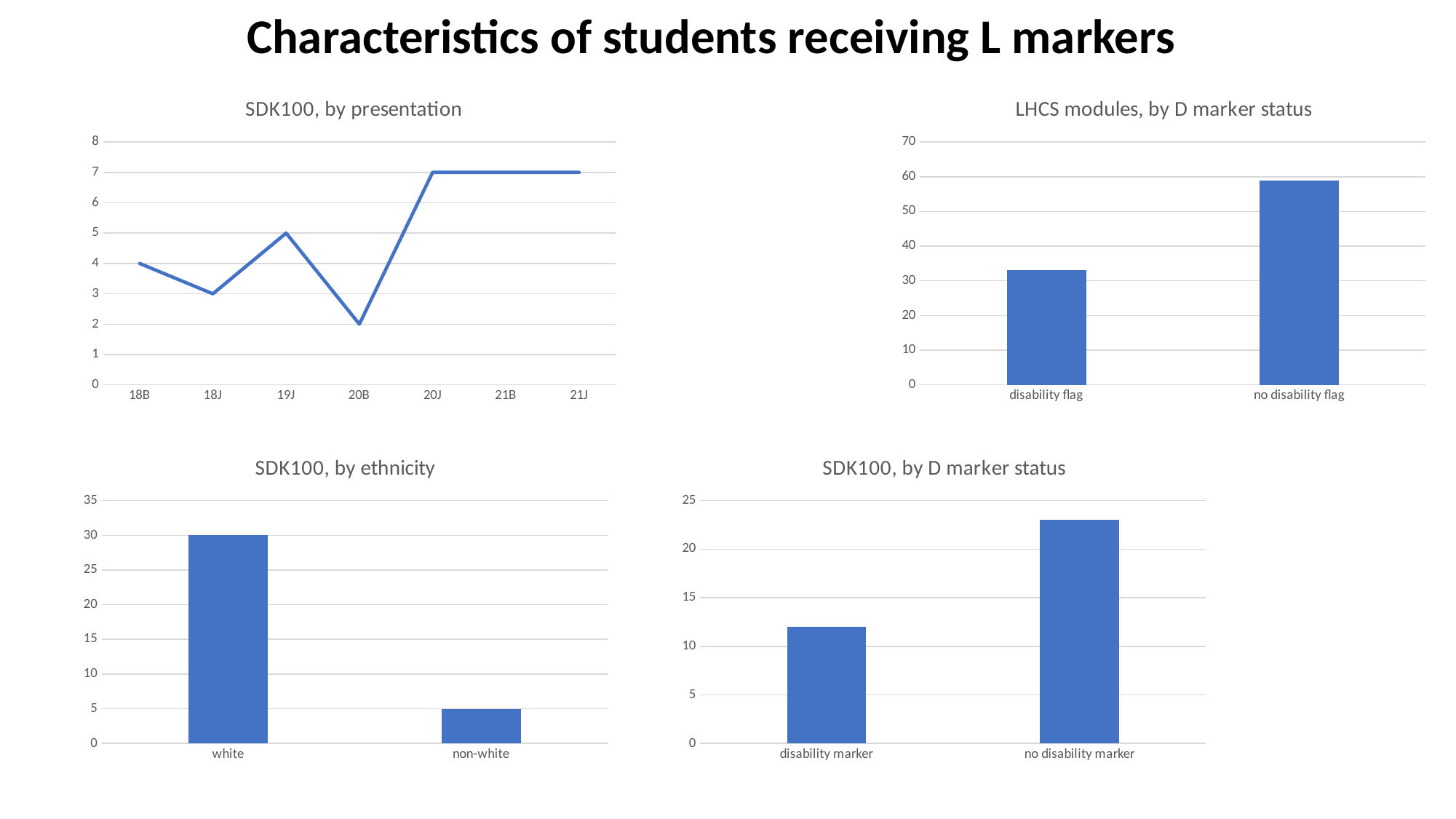
What kind of chart is 'SDK100, by presentation'? line chart In the 'SDK100, by ethnicity' chart, what is the difference between the values for 'white' and 'non-white'? 25 In the 'SDK100, by presentation' chart, what is the value for 20B? 2 In the 'LHCS modules, by D marker status' chart, which category has the higher value? no disability flag In the 'SDK100, by presentation' chart, what is the value for 18B? 4 What kind of chart is 'SDK100, by D marker status'? bar chart In the 'SDK100, by D marker status' chart, is the value for 'disability marker' greater or less than 15? less How many presentations are plotted on the x axis of the 'SDK100, by presentation' chart? 7 In the 'SDK100, by presentation' chart, which presentation has the lowest value? 20B In the 'SDK100, by ethnicity' chart, what is the value for 'non-white'? 5 In the 'SDK100, by ethnicity' chart, what is the value for 'white'? 30 In the 'LHCS modules, by D marker status' chart, is the value for 'no disability flag' greater or less than 50? greater